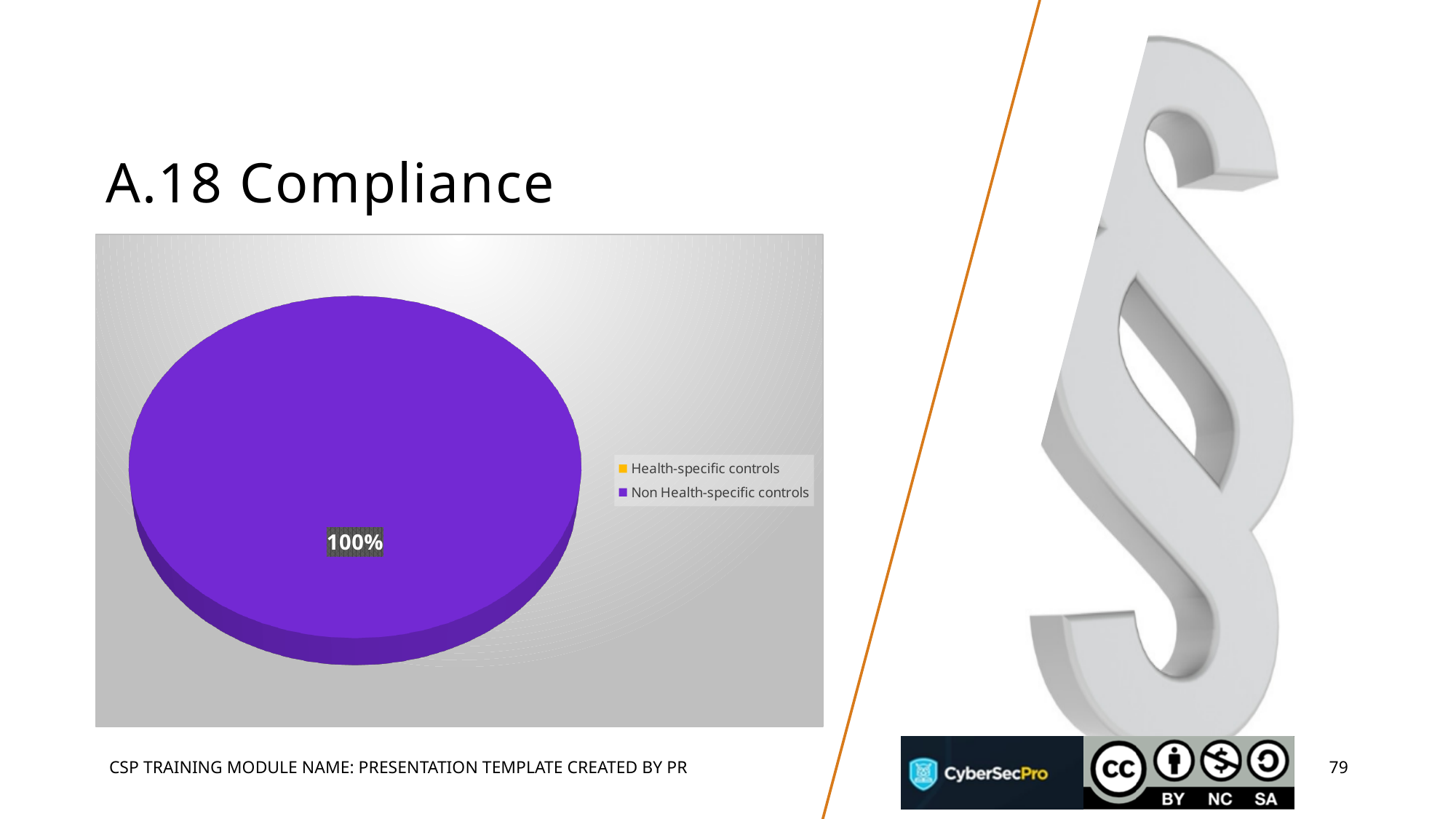
What colour is the Non Health-specific controls slice in the pie chart? purple Which category has the largest share of the pie chart? Non Health-specific controls Which is larger in the pie chart, Health-specific controls or Non Health-specific controls? Non Health-specific controls What value is printed as the data label on the pie chart? 100% Which category has the smallest share of the pie chart? Health-specific controls How many entries does the legend of the pie chart list? 2 Is the share for Non Health-specific controls greater or less than 50%? greater What kind of chart is shown on the slide? pie chart Which legend entry of the pie chart has no visible slice? Health-specific controls What share of the pie does the Non Health-specific controls slice take? 100%